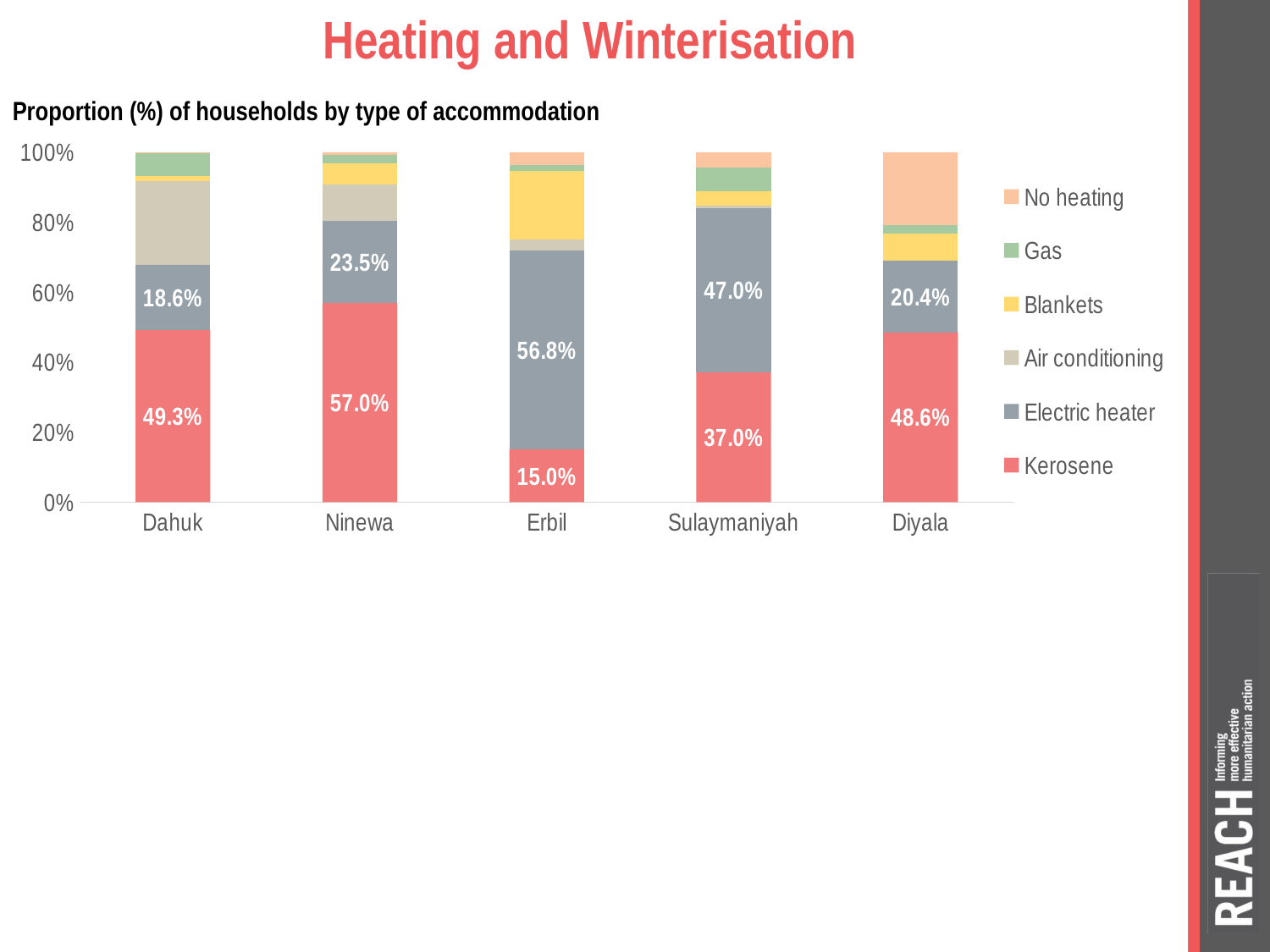
What is the Electric heater value for Erbil? 56.8% Which governorate has the highest Kerosene value? Ninewa What is the Kerosene value for Dahuk? 49.3% What kind of chart is shown on the slide? Stacked bar chart Which governorate has the lowest Kerosene value? Erbil What is the Electric heater value for Diyala? 20.4% Which is larger, the Electric heater value for Sulaymaniyah or for Ninewa? Sulaymaniyah What is the difference between the Kerosene values for Ninewa and Dahuk? 7.7% Which governorate has the highest Electric heater value? Erbil How many governorates are shown on the x axis? 5 What is the Kerosene value for Sulaymaniyah? 37.0% How many series does the legend list? 6